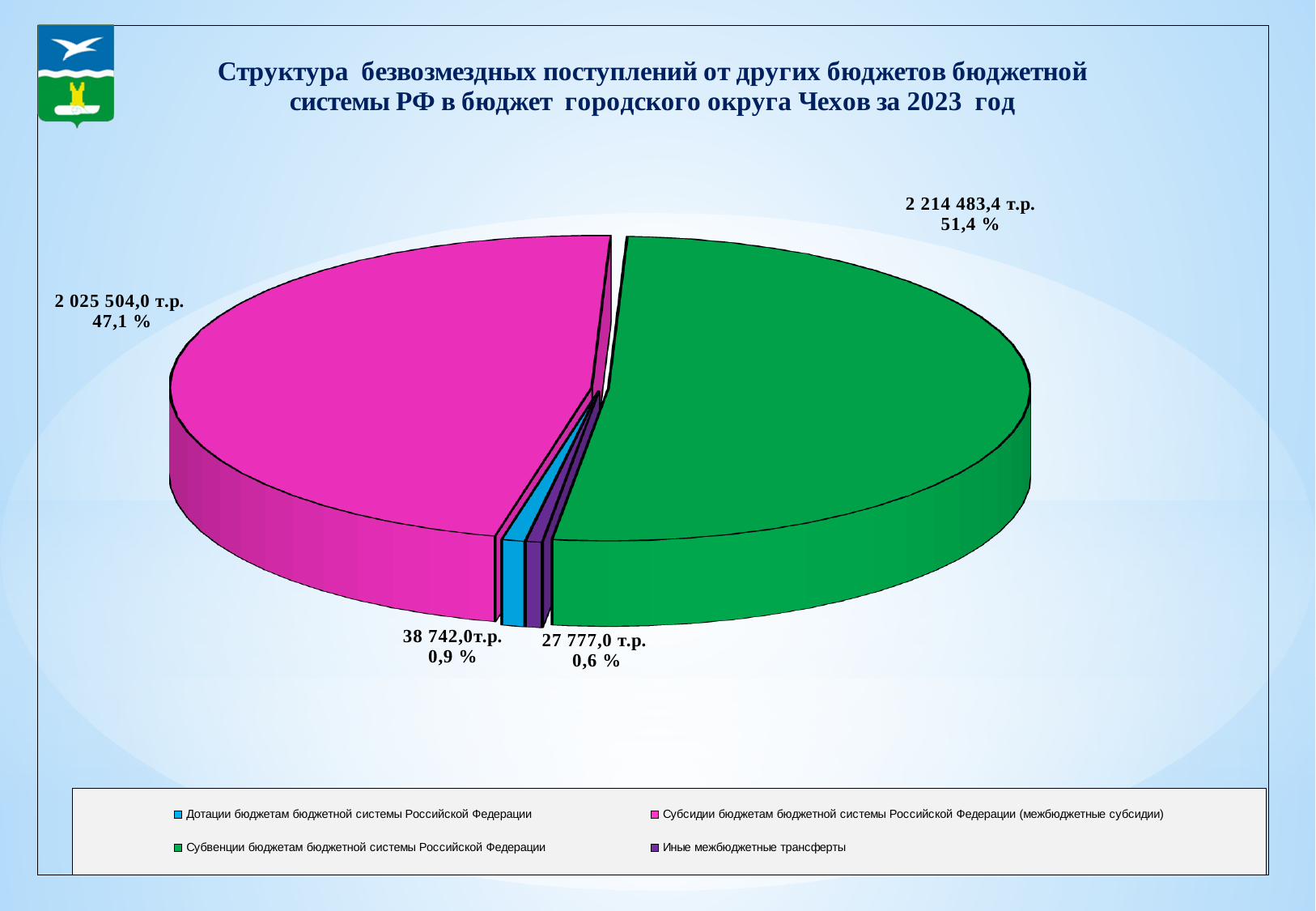
What is the value shown for Субсидии бюджетам бюджетной системы Российской Федерации (межбюджетные субсидии)? 2 025 504,0 т.р. What kind of chart is shown on the slide? Pie chart What colour is the slice for Субсидии бюджетам бюджетной системы Российской Федерации (межбюджетные субсидии)? Magenta (pink) What is the value shown for Иные межбюджетные трансферты? 27 777,0 т.р. What is the value shown for Дотации бюджетам бюджетной системы Российской Федерации? 38 742,0т.р. Which category has the largest slice of the pie? Субвенции бюджетам бюджетной системы Российской Федерации What is the value shown for Субвенции бюджетам бюджетной системы Российской Федерации? 2 214 483,4 т.р. What share of the pie does Субвенции бюджетам бюджетной системы Российской Федерации represent? 51,4 % How many entries does the legend list? 4 How many slices does the pie chart have? 4 Which category has the smallest slice of the pie? Иные межбюджетные трансферты What share of the pie does Иные межбюджетные трансферты represent? 0,6 %